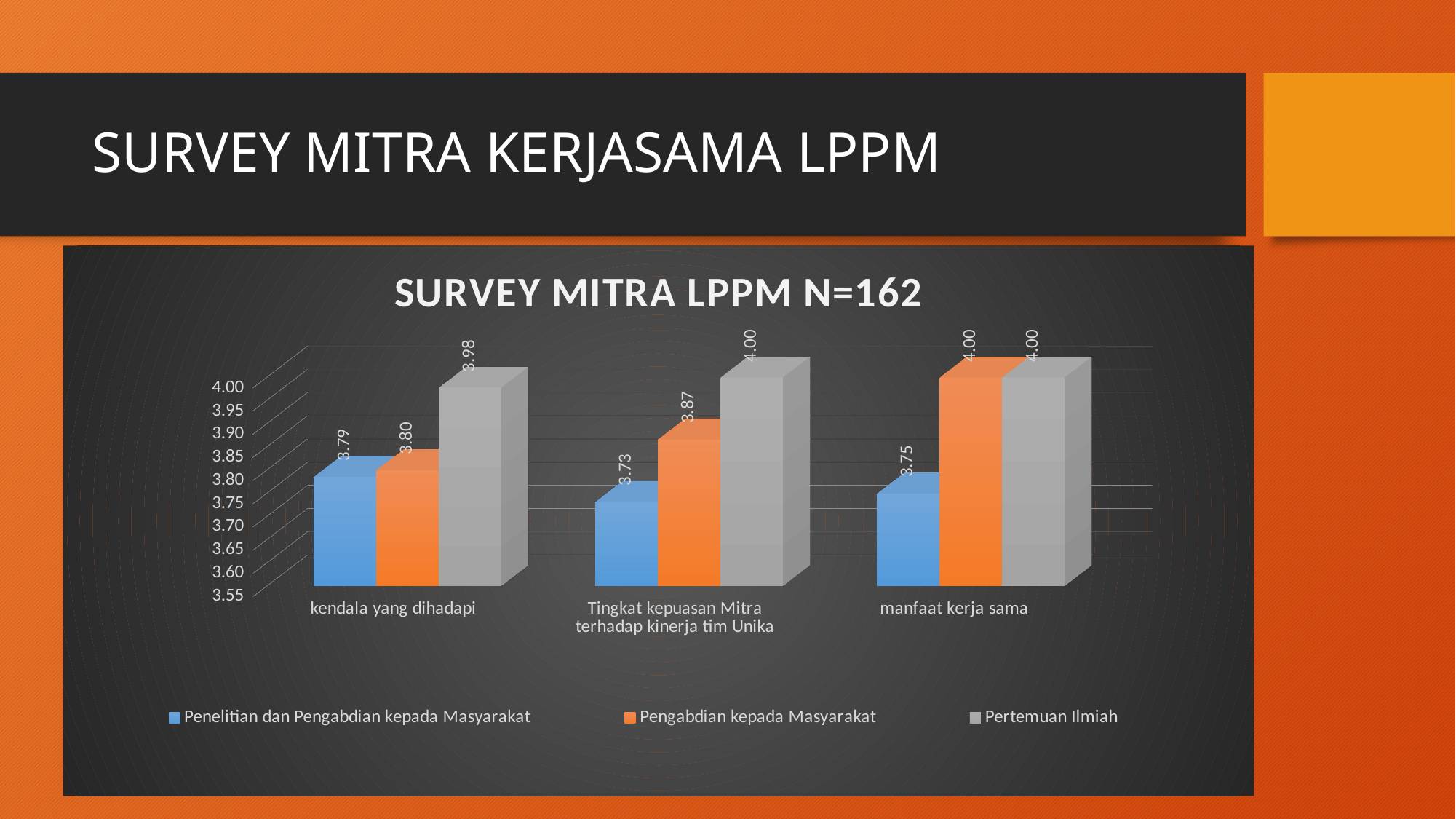
What is the difference between the Pertemuan Ilmiah value and the Penelitian dan Pengabdian kepada Masyarakat value in the Tingkat kepuasan Mitra terhadap kinerja tim Unika category? 0.27 Which series has the lowest value in the kendala yang dihadapi category? Penelitian dan Pengabdian kepada Masyarakat Which series has the highest value in the Tingkat kepuasan Mitra terhadap kinerja tim Unika category? Pertemuan Ilmiah How many categories are shown on the x axis? 3 What is the value for Pengabdian kepada Masyarakat in the manfaat kerja sama category? 4.00 What kind of chart is shown on the slide? Bar chart What is the value for Pertemuan Ilmiah in the kendala yang dihadapi category? 3.98 What is the title of the chart? SURVEY MITRA LPPM N=162 How many series does the legend list? 3 What is the value for Penelitian dan Pengabdian kepada Masyarakat in the Tingkat kepuasan Mitra terhadap kinerja tim Unika category? 3.73 Which is larger: the Pengabdian kepada Masyarakat value for kendala yang dihadapi or for Tingkat kepuasan Mitra terhadap kinerja tim Unika? Tingkat kepuasan Mitra terhadap kinerja tim Unika Which colour represents the Pertemuan Ilmiah series? Grey